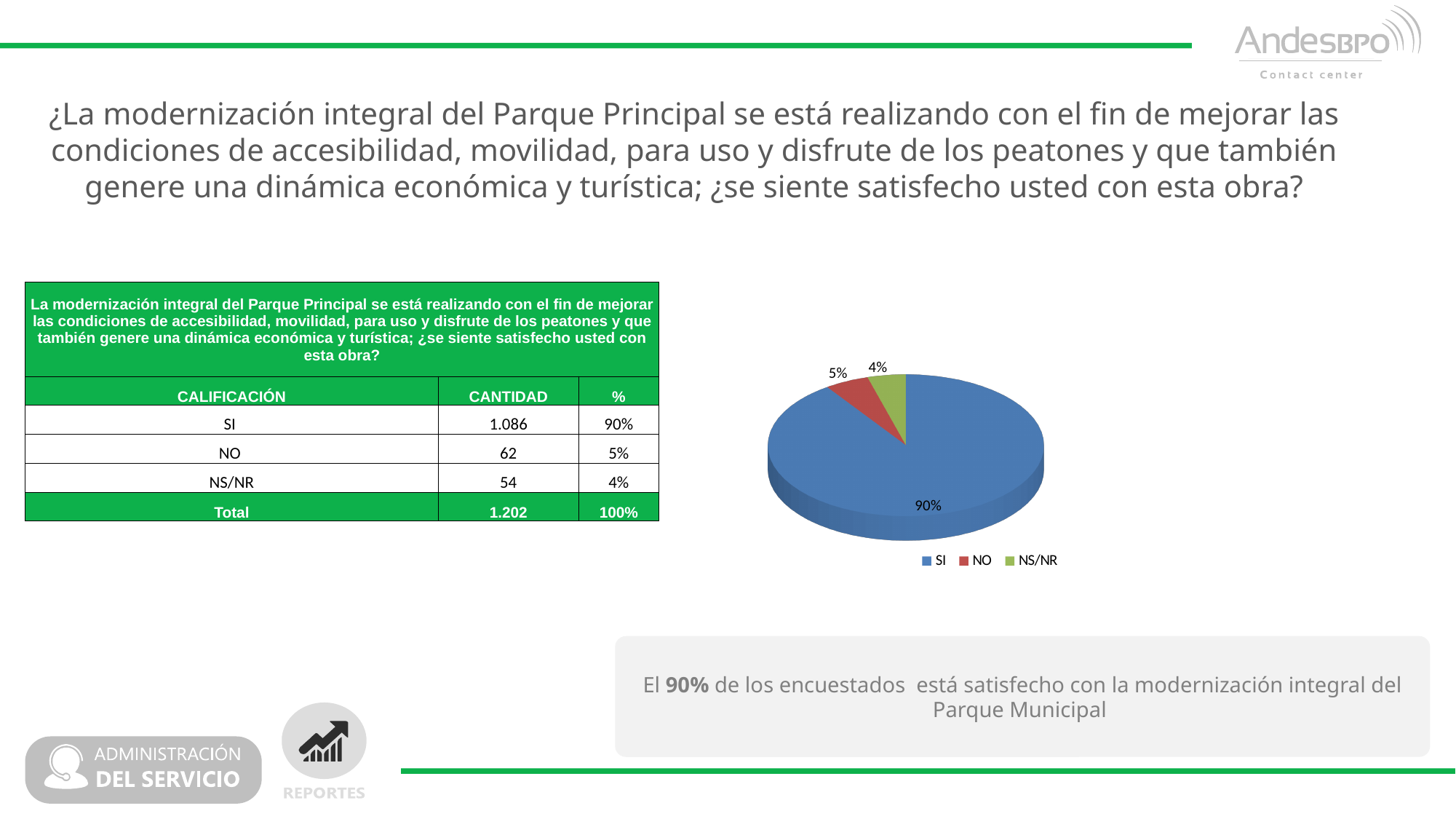
Which slice is larger, NO or NS/NR? NO What colour is the NS/NR slice in the pie chart? green How many entries does the legend of the pie chart list? 3 What share of the pie does the SI slice represent? 90% What share of the pie does the NO slice represent? 5% What is the difference in percentage points between the SI slice and the NO slice? 85% Which category has the largest slice in the pie chart? SI How many slices does the pie chart have? 3 What kind of chart is shown on the slide? pie chart What share of the pie does the NS/NR slice represent? 4% Which category has the smallest slice in the pie chart? NS/NR What colour is the SI slice in the pie chart? blue